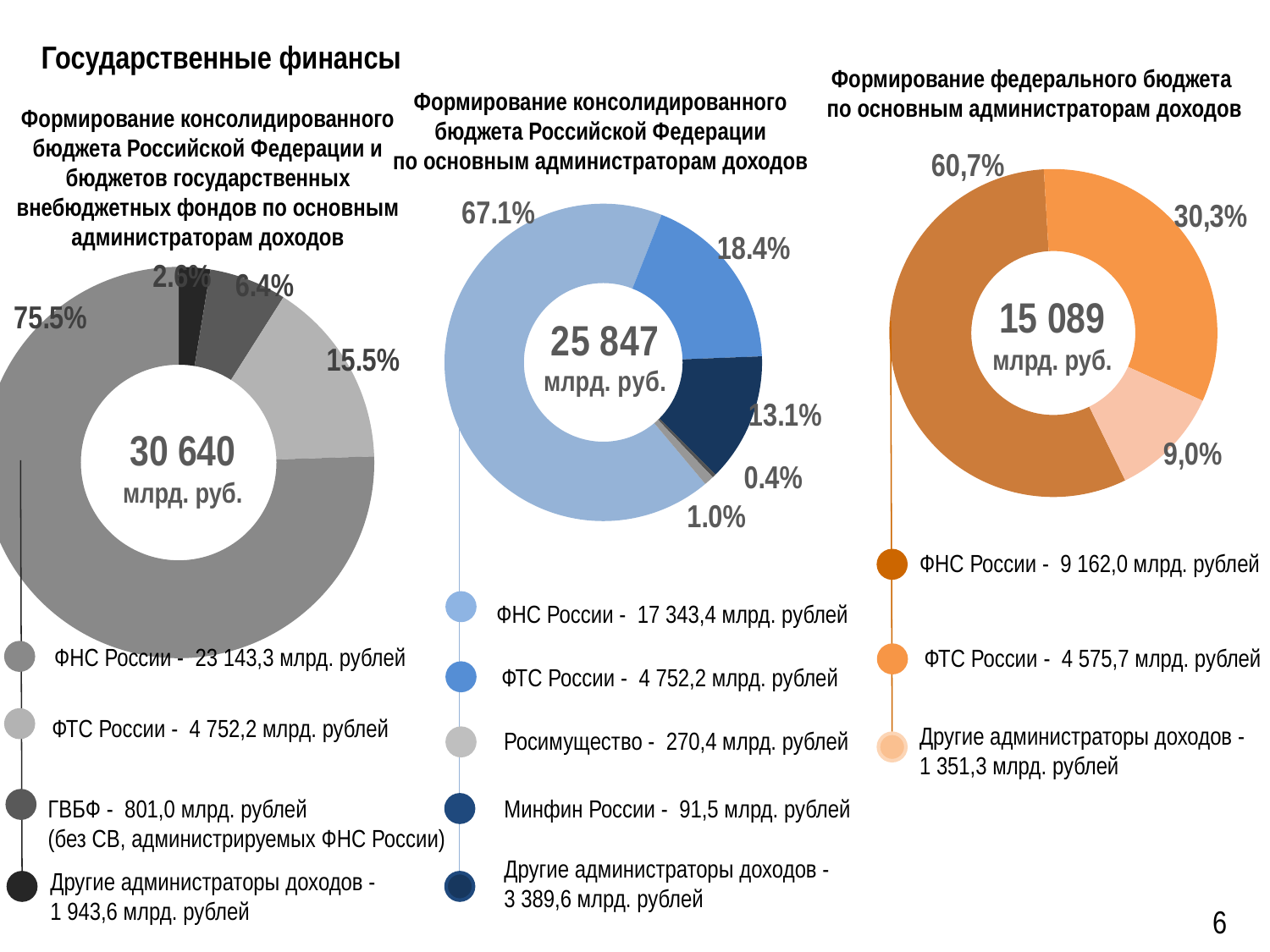
In the left chart (consolidated budget and state extra-budgetary funds), what total is shown in the centre of the donut? 30 640 млрд. руб. In the middle chart ("Формирование консолидированного бюджета Российской Федерации по основным администраторам доходов"), what share does ФНС России account for? 67.1% In the middle chart ("Формирование консолидированного бюджета Российской Федерации по основным администраторам доходов"), what value is shown for Минфин России? 91,5 млрд. рублей In the left chart (consolidated budget and state extra-budgetary funds), which administrator has the largest share? ФНС России In the chart titled "Формирование федерального бюджета по основным администраторам доходов", what value is shown for ФНС России? 9 162,0 млрд. рублей In the chart titled "Формирование федерального бюджета по основным администраторам доходов", what share of the total does ФТС России account for? 30,3% In the chart titled "Формирование федерального бюджета по основным администраторам доходов", what total is shown in the centre of the donut? 15 089 млрд. руб. In the left chart (consolidated budget and state extra-budgetary funds), what value is shown for ГВБФ? 801,0 млрд. рублей In the middle chart ("Формирование консолидированного бюджета Российской Федерации по основным администраторам доходов"), which administrator has the smallest share? Минфин России What type of chart is used for all three charts on the slide? Donut (pie) chart In the middle chart ("Формирование консолидированного бюджета Российской Федерации по основным администраторам доходов"), how many categories are listed in the legend? 5 In the chart titled "Формирование федерального бюджета по основным администраторам доходов", which is larger: the value for ФТС России or for Другие администраторы доходов? ФТС России